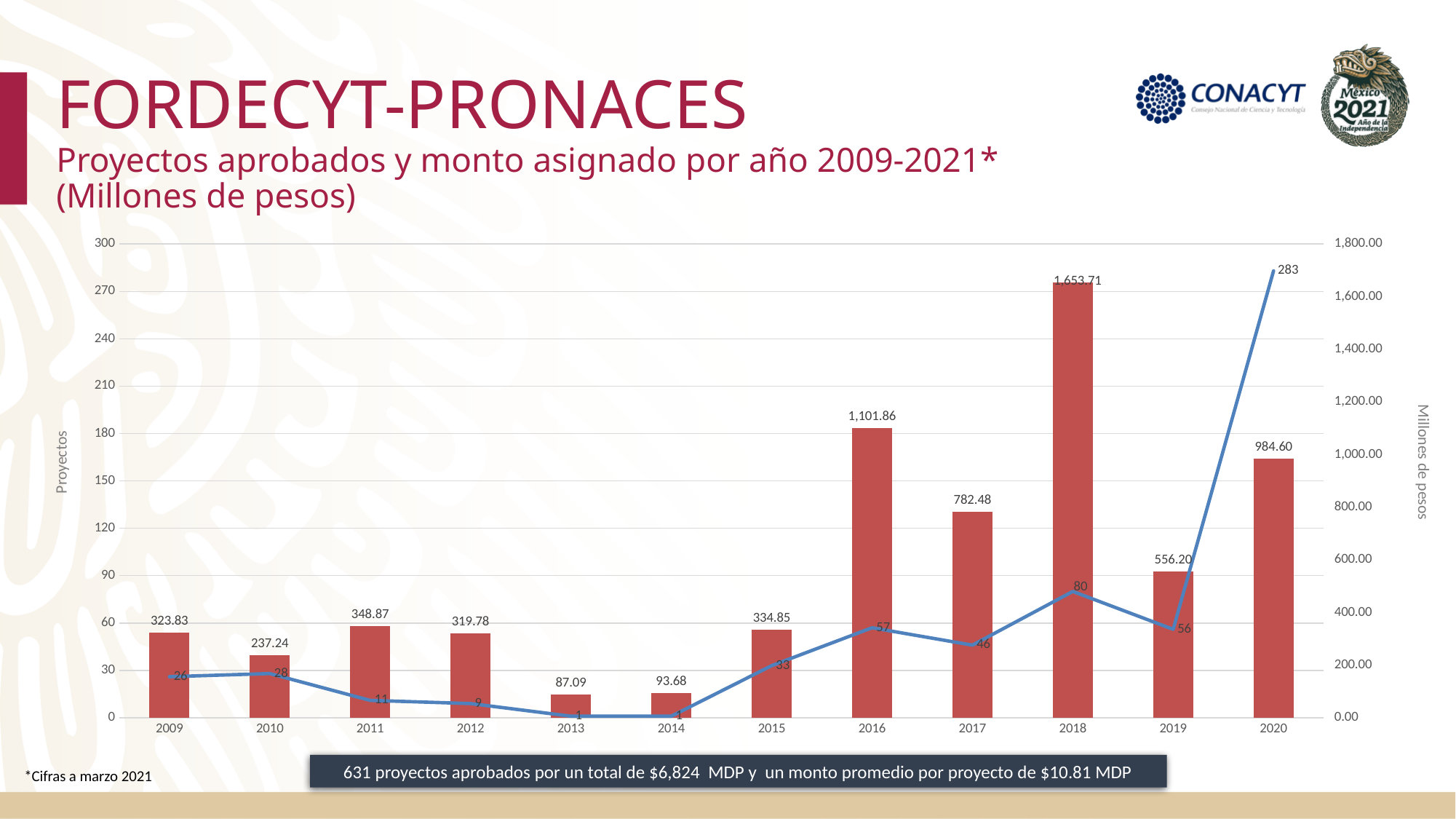
Which year has the lowest bar (smallest amount in millions of pesos)? 2013 What is the amount (in millions of pesos) shown by the bar for 2018? 1,653.71 How many years are shown on the x axis? 12 What kind of chart is this? Combined bar and line chart What is the label of the left vertical axis? Proyectos How many projects does the line show for 2020? 283 What is the difference between the bar values for 2018 and 2016? 551.85 Which year has the highest bar (largest amount in millions of pesos)? 2018 What is the amount shown by the bar for 2016? 1,101.86 Which year has a larger bar value, 2017 or 2019? 2017 Which year has the highest number of projects on the line? 2020 How many projects does the line show for 2013? 1